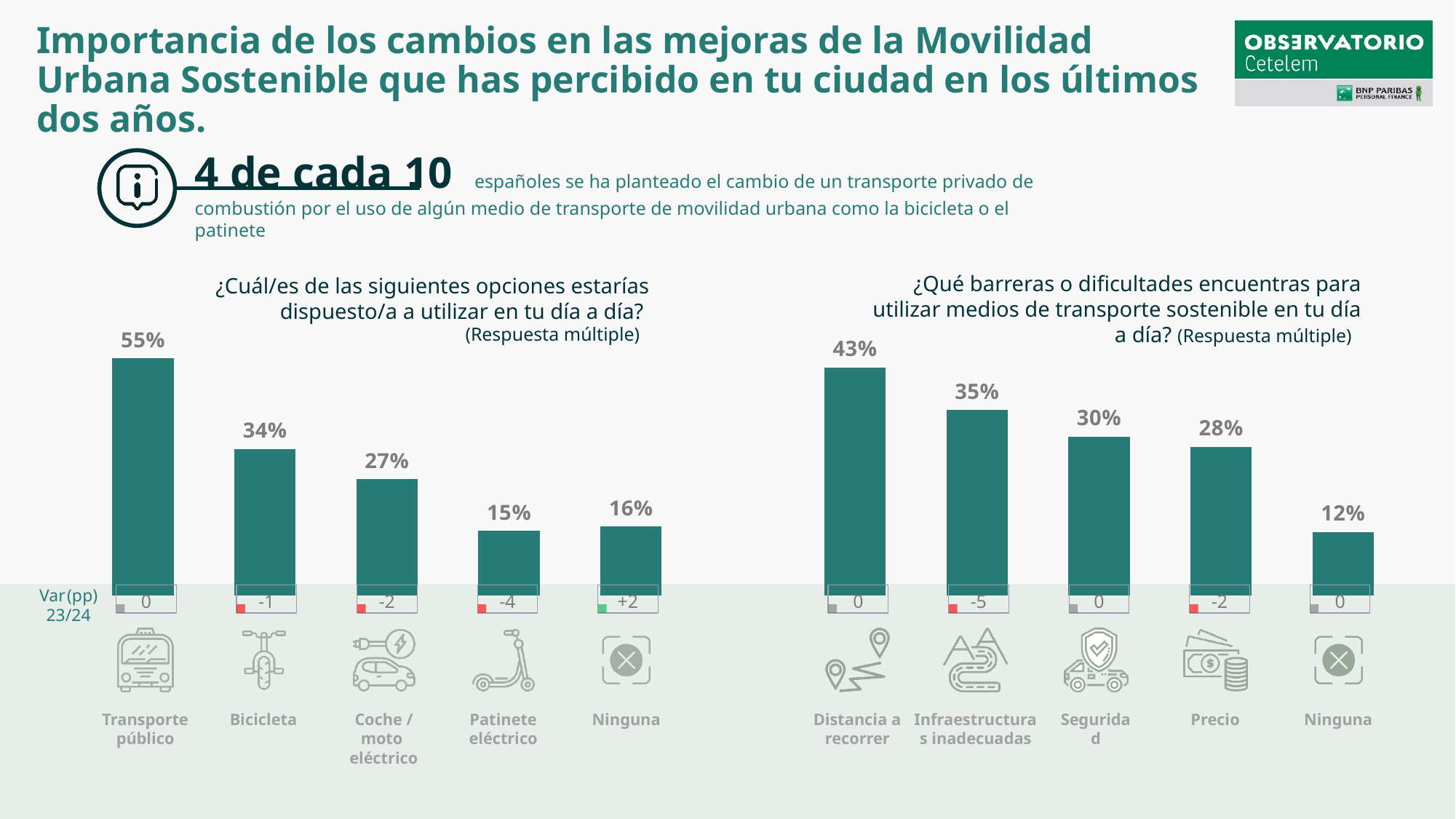
In the right chart (¿Qué barreras o dificultades encuentras para utilizar medios de transporte sostenible en tu día a día?), which category has the highest value? Distancia a recorrer In the right chart (¿Qué barreras o dificultades encuentras para utilizar medios de transporte sostenible en tu día a día?), which is larger: Infraestructuras inadecuadas or Seguridad? Infraestructuras inadecuadas In the left chart (¿Cuál/es de las siguientes opciones estarías dispuesto/a a utilizar en tu día a día?), what is the value for Coche / moto eléctrico? 27% In the right chart (¿Qué barreras o dificultades encuentras para utilizar medios de transporte sostenible en tu día a día?), what is the value for Distancia a recorrer? 43% In the left chart (¿Cuál/es de las siguientes opciones estarías dispuesto/a a utilizar en tu día a día?), how many categories are shown? 5 In the left chart (¿Cuál/es de las siguientes opciones estarías dispuesto/a a utilizar en tu día a día?), what is the difference between Transporte público and Bicicleta? 21 percentage points In the left chart (¿Cuál/es de las siguientes opciones estarías dispuesto/a a utilizar en tu día a día?), which category has the lowest value? Patinete eléctrico In the right chart (¿Qué barreras o dificultades encuentras para utilizar medios de transporte sostenible en tu día a día?), what is the value for Precio? 28% In the left chart (¿Cuál/es de las siguientes opciones estarías dispuesto/a a utilizar en tu día a día?), what is the value for Transporte público? 55% In the left chart (¿Cuál/es de las siguientes opciones estarías dispuesto/a a utilizar en tu día a día?), what is the Var(pp) 23/24 shown for Patinete eléctrico? -4 In the right chart (¿Qué barreras o dificultades encuentras para utilizar medios de transporte sostenible en tu día a día?), what is the Var(pp) 23/24 shown for Infraestructuras inadecuadas? -5 What type of chart is used for the two charts on the slide? Bar chart